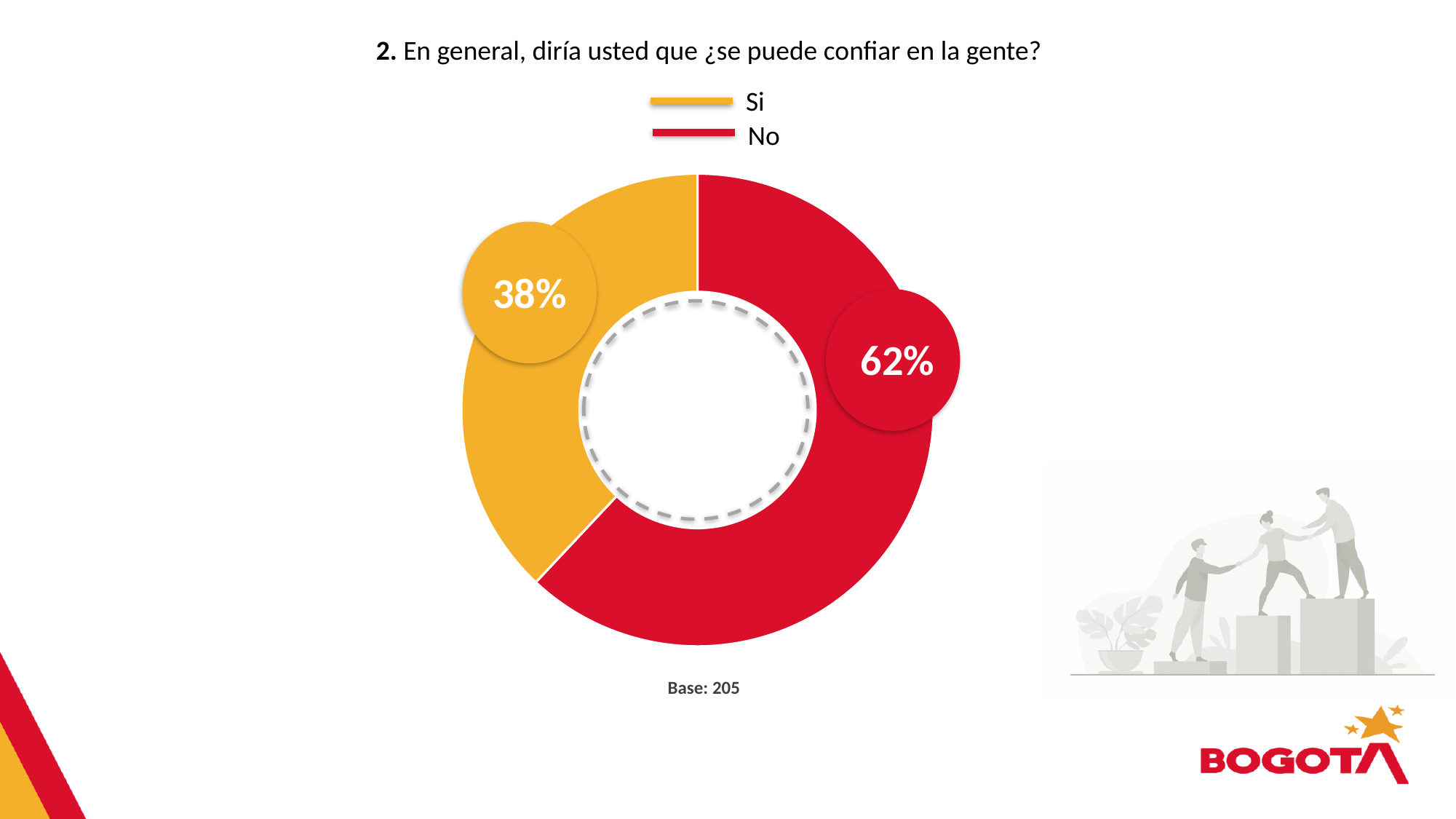
Which response has the smallest share of the chart? Si What is the difference in percentage points between the "No" and "Si" responses? 24 Which is larger, the share for "Si" or the share for "No"? No What percentage of respondents answered "Si"? 38% What kind of chart is shown on the slide? Pie chart (donut) What percentage of respondents answered "No"? 62% What is the combined total of the "Si" and "No" shares? 100% How many entries does the legend list? 2 Which response has the largest share of the chart? No How many categories are shown in the chart? 2 Which colour represents the "No" response in the chart? Red What is the base (number of respondents) shown below the chart? 205